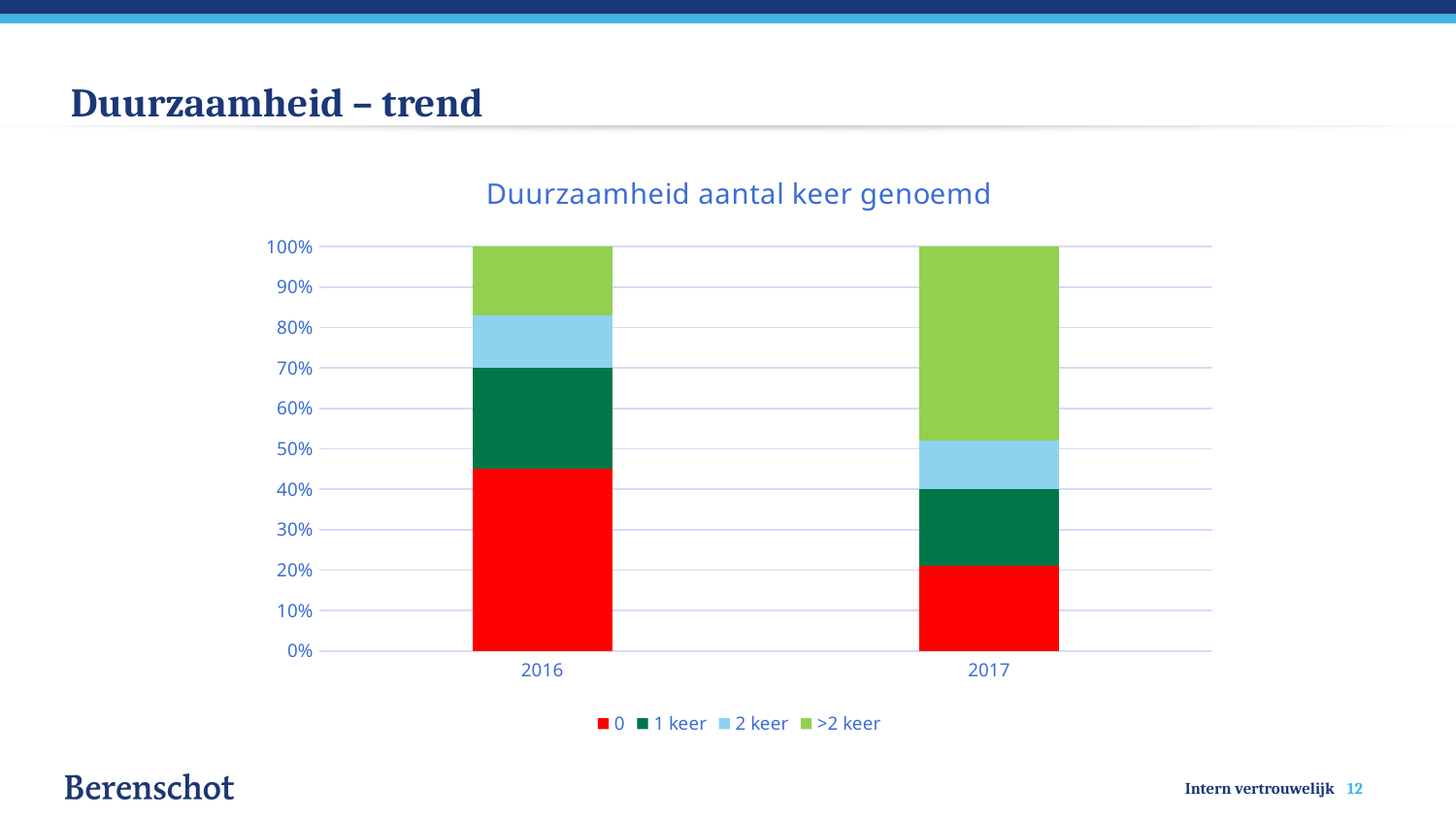
How many years are shown on the x axis of the chart? 2 Is the share of '0' in 2016 greater or less than 40%? greater What is the title of the chart? Duurzaamheid aantal keer genoemd What kind of chart is shown on the slide? Stacked bar chart Is the share of '>2 keer' in 2017 greater or less than 40%? greater In which year is the share of '>2 keer' larger, 2016 or 2017? 2017 Is the share of '>2 keer' in 2016 greater or less than 30%? less In which year is the share of '0' larger, 2016 or 2017? 2016 How many series does the legend of the chart list? 4 Does the share of '0' rise or fall from 2016 to 2017? Fall Which colour represents the '0' series in the chart? Red